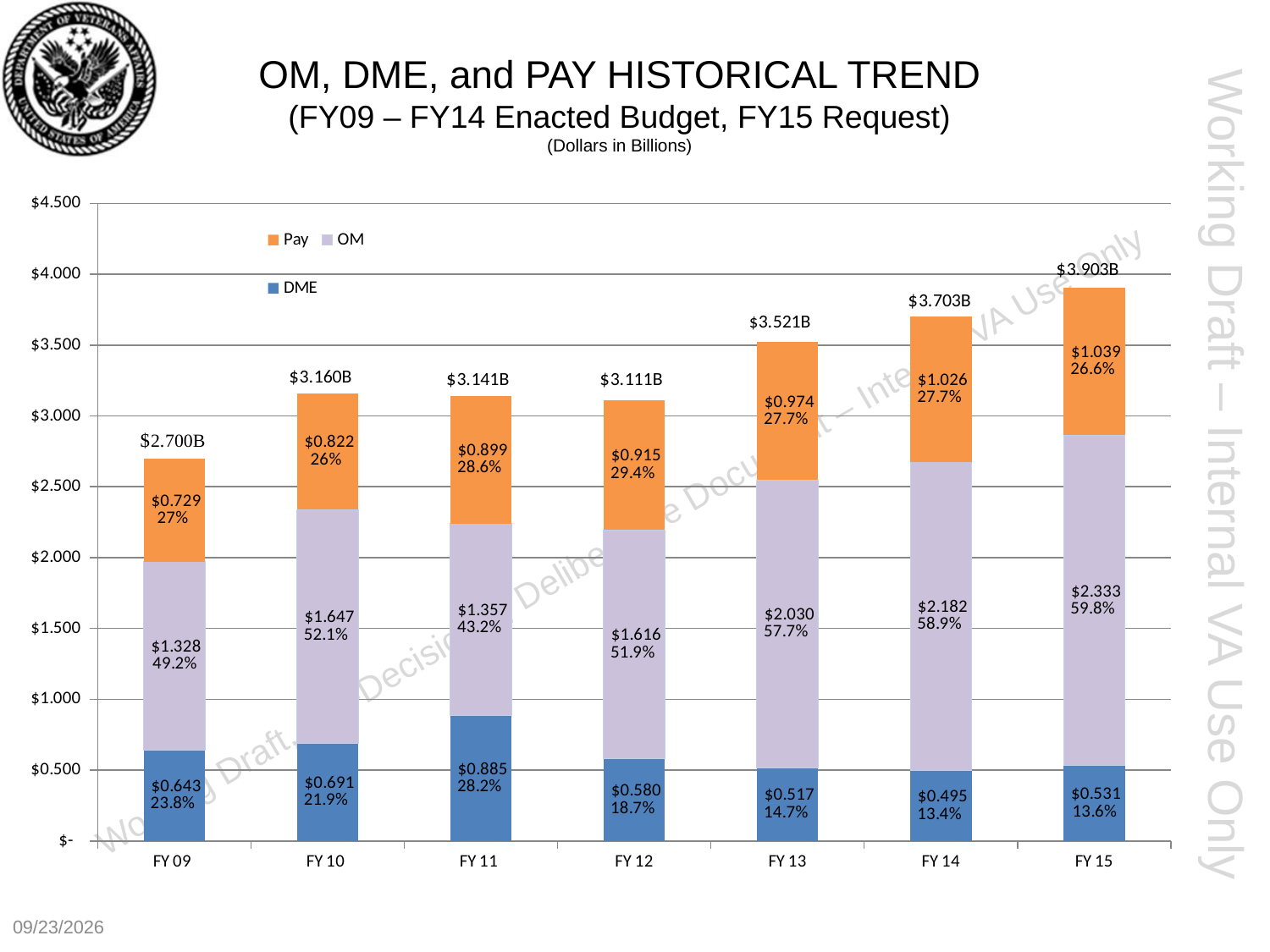
What is the Pay value for FY 11? $0.899 Which fiscal year has the highest total bar? FY 15 What is the OM value for FY 13? $2.030 How many fiscal years are shown on the x axis? 7 What kind of chart is shown on the slide? Stacked bar chart Which fiscal year has the lowest DME value? FY 14 Which is larger, the OM value for FY 10 or the OM value for FY 11? FY 10 What is the total of the stacked bar for FY 12? $3.111B What percentage share does DME represent in FY 12? 18.7% What is the difference between the Pay value for FY 15 and the Pay value for FY 09? $0.310 Is the total for FY 14 greater or less than $3.500? greater How many series does the legend list? 3